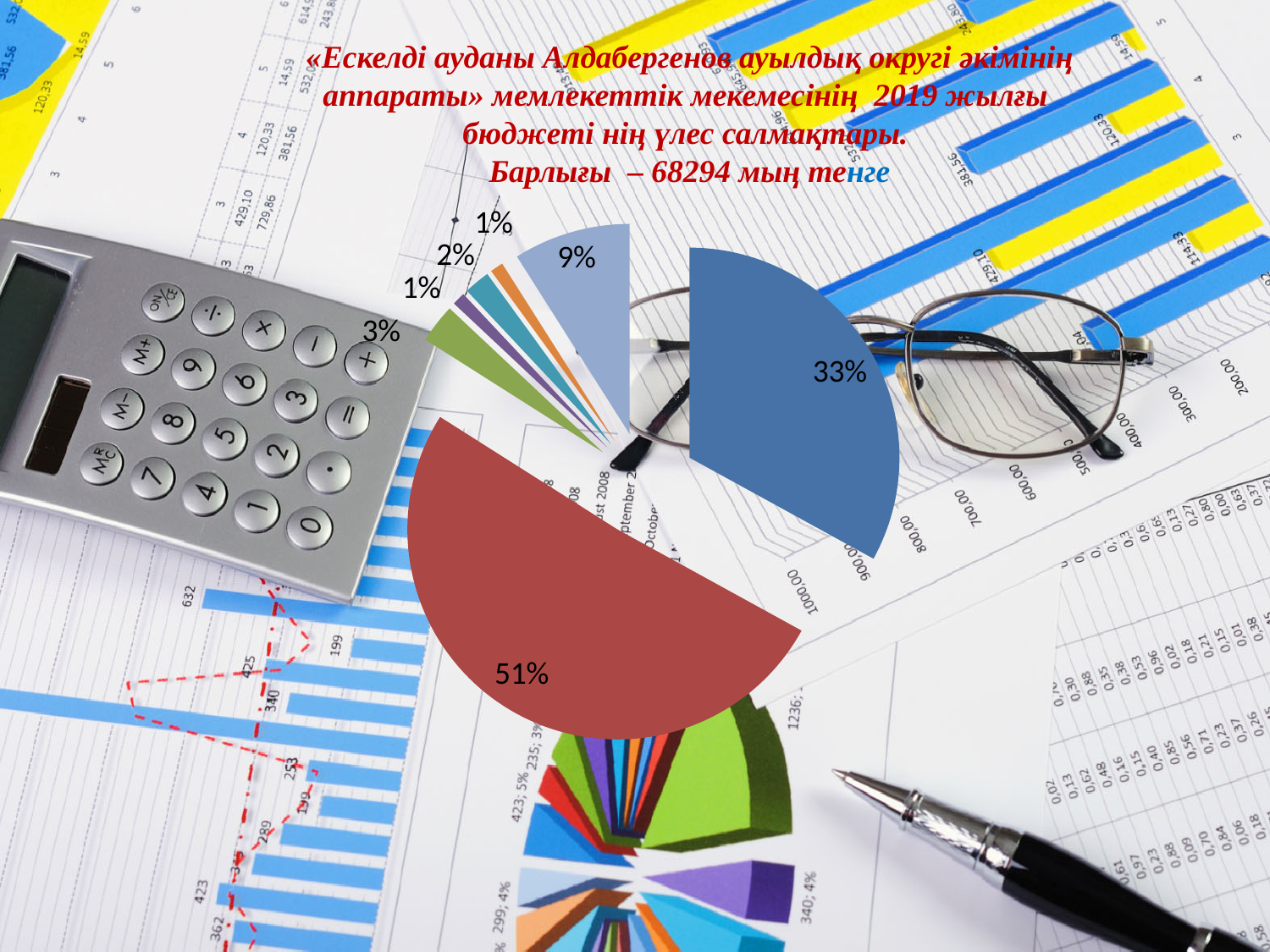
What is the share of the green slice of the pie chart? 3% What is the difference in percentage points between the two largest slices of the pie chart? 18 percentage points What is the share of the largest slice of the pie chart? 51% What is the share of the light blue slice at the top of the pie chart? 9% What colour is the largest slice of the pie chart? red What is the share of the blue slice on the right side of the pie chart? 33% How many slices of the pie chart are labelled 1%? 2 Which is larger, the red slice or the blue slice of the pie chart? the red slice What kind of chart is shown on the slide? pie chart What is the share of the smallest slice of the pie chart? 1% How many slices does the pie chart have? 7 What total amount (in thousand tenge) does the slide title state for the 2019 budget? 68294